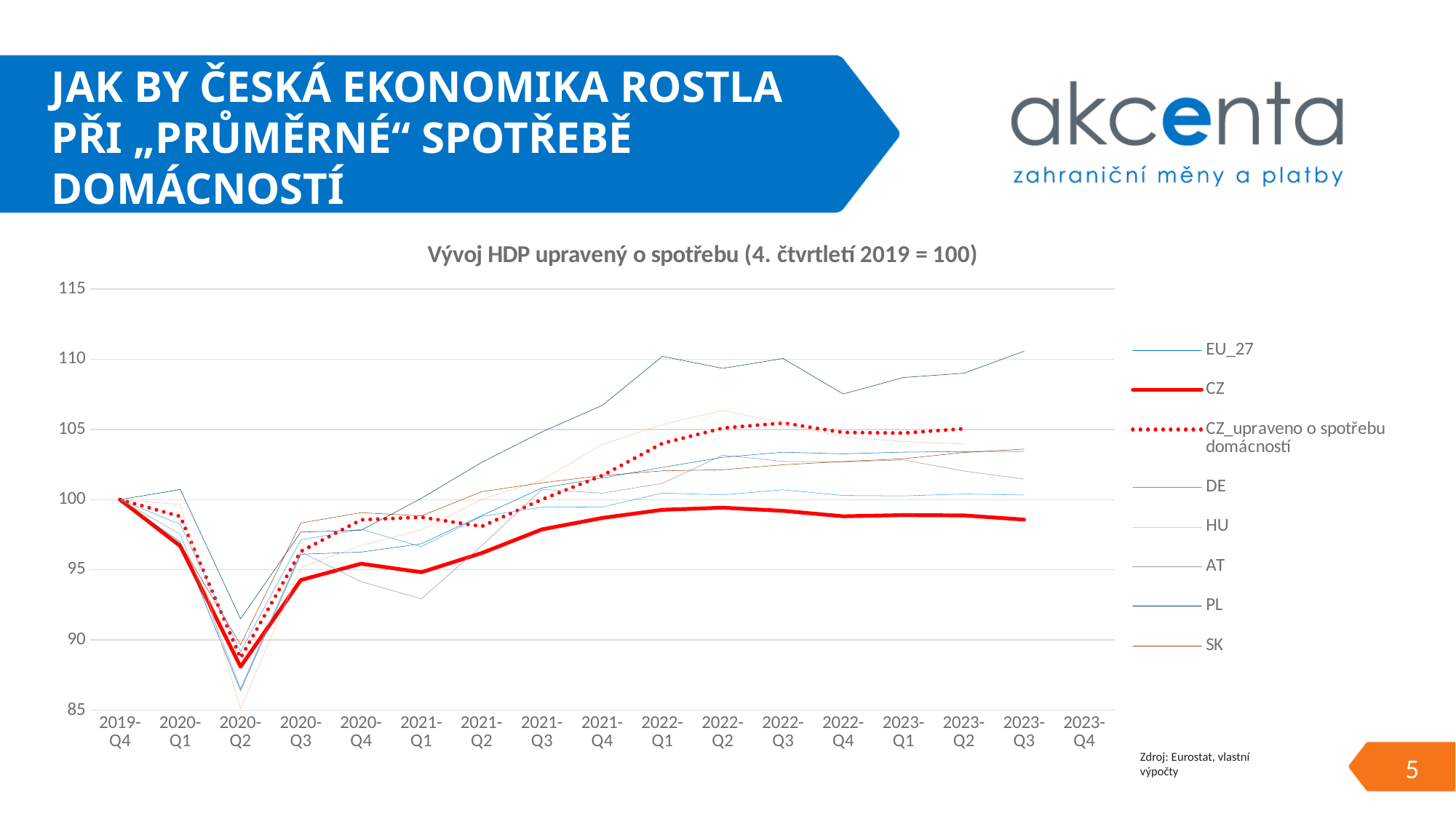
Which series is drawn as a dotted red line? CZ_upraveno o spotřebu domácností What kind of chart is shown on the slide? line chart Is the value for CZ in 2023-Q3 greater or less than 100? less Which series has the lowest value in 2020-Q2? HU In which quarter does the CZ line reach its lowest point? 2020-Q2 Is the value for CZ in 2020-Q2 greater or less than 90? less How many quarters are labelled along the x axis? 17 Which series has the highest value in 2023-Q3? PL What is the title of the chart? Vývoj HDP upravený o spotřebu (4. čtvrtletí 2019 = 100) In 2023-Q2, which is higher: CZ or CZ_upraveno o spotřebu domácností? CZ_upraveno o spotřebu domácností How many series does the legend list? 8